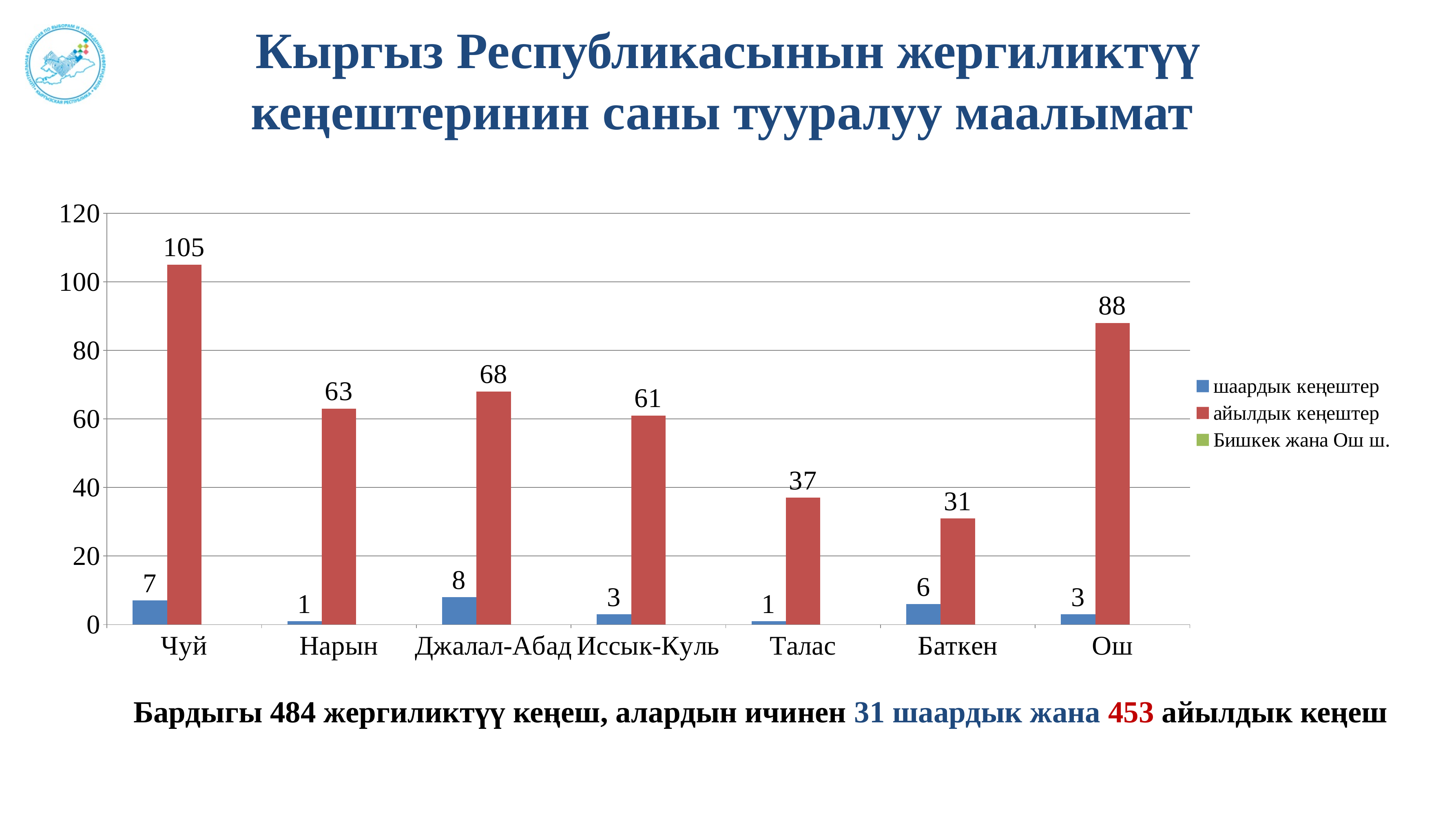
How many series does the legend list? 3 What is the value of айылдык кеңештер for Ош? 88 What is the value of айылдык кеңештер for Чуй? 105 Which region has the highest value for шаардык кеңештер? Джалал-Абад How many regions are shown on the x axis? 7 Which is larger, the айылдык кеңештер value for Нарын or for Иссык-Куль? Нарын What is the difference between the айылдык кеңештер values for Чуй and Ош? 17 Which region has the highest value for айылдык кеңештер? Чуй Is the айылдык кеңештер value for Талас greater or less than 40? less What is the value of шаардык кеңештер for Баткен? 6 Which region has the lowest value for айылдык кеңештер? Баткен What kind of chart is shown on the slide? bar chart